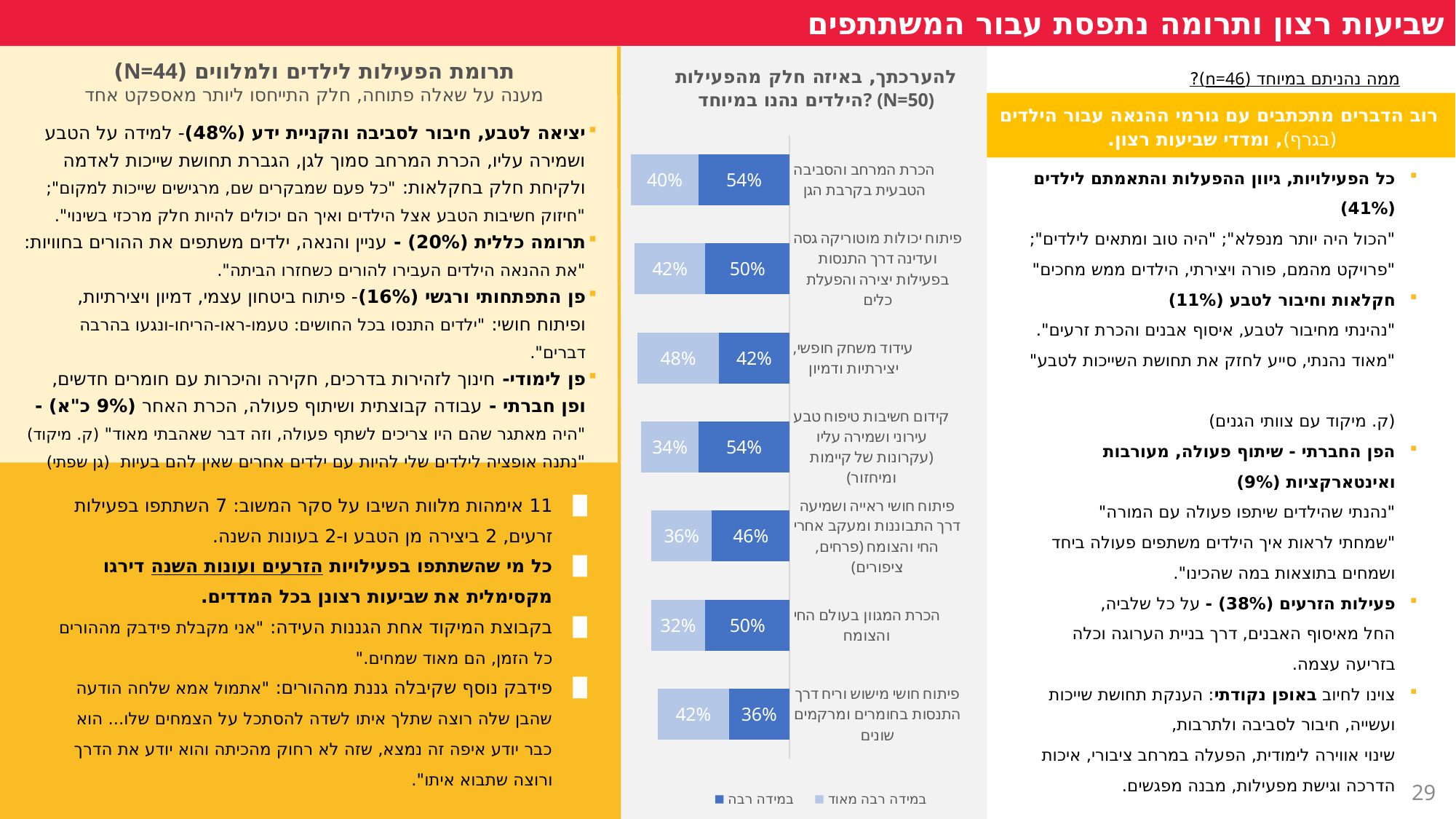
Which category has the lowest 'במידה רבה מאוד' (light blue) value? הכרת המגוון בעולם החי והצומח How many series does the chart's legend list? 2 What is the combined total of the two segments for 'הכרת המרחב והסביבה הטבעית בקרבת הגן'? 94% What is the 'במידה רבה מאוד' (light blue) value for 'עידוד משחק חופשי, יצירתיות ודמיון'? 48% What is the difference between the 'במידה רבה' and 'במידה רבה מאוד' values for 'קידום חשיבות טיפוח טבע עירוני ושמירה עליו'? 20% Which category has the lowest 'במידה רבה' (dark blue) value? פיתוח חושי מישוש וריח דרך התנסות בחומרים ומרקמים שונים Which series is shown in dark blue in the chart's legend? במידה רבה What is the 'במידה רבה' (dark blue) value for 'הכרת המרחב והסביבה הטבעית בקרבת הגן'? 54% What is the 'במידה רבה מאוד' (light blue) value for 'פיתוח חושי מישוש וריח דרך התנסות בחומרים ומרקמים שונים'? 42% How many categories (activity areas) does the chart show? 7 What kind of chart is shown on the slide? stacked bar chart What is the 'במידה רבה' (dark blue) value for 'הכרת המגוון בעולם החי והצומח'? 50%